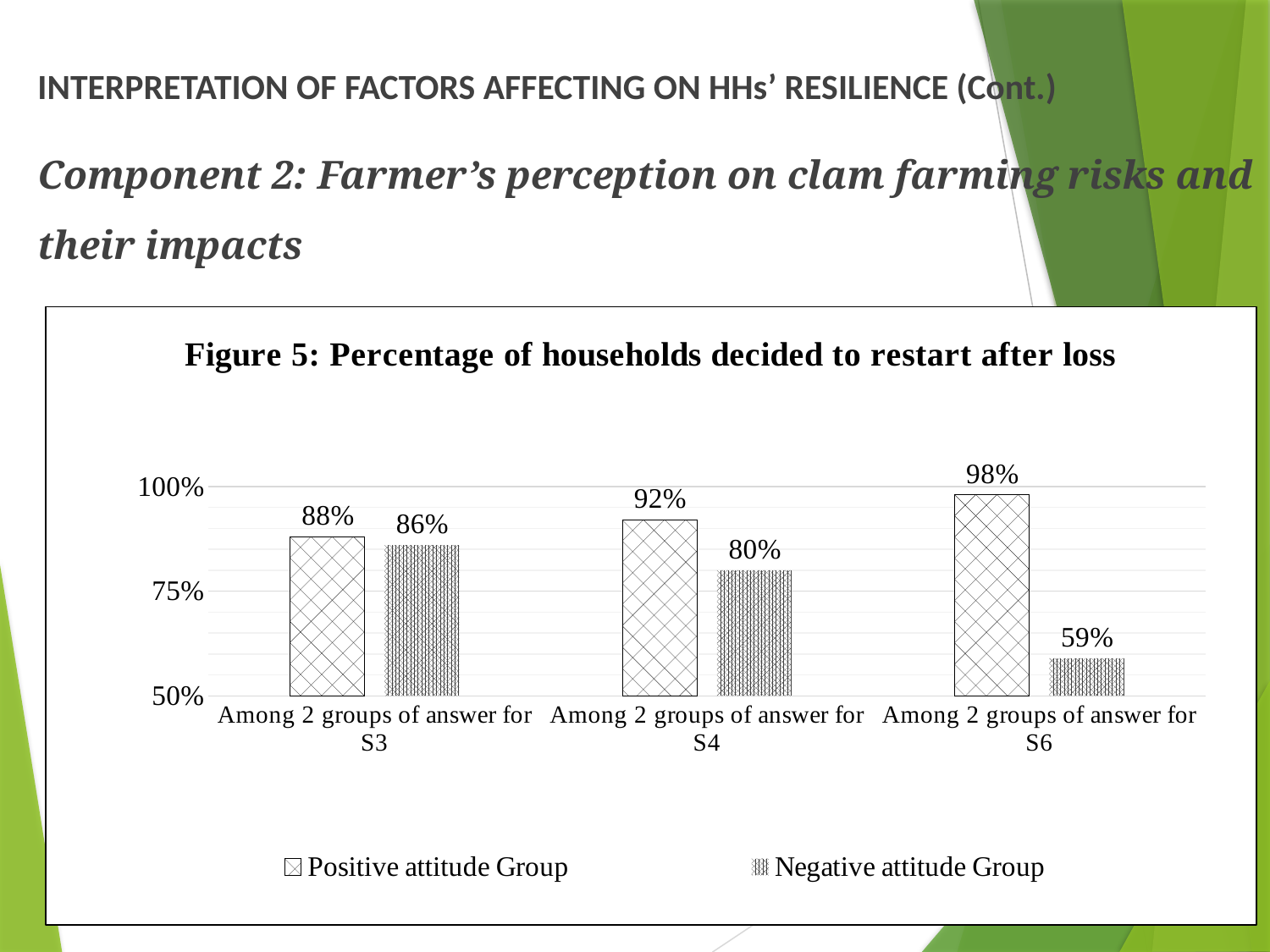
What is the difference between the Positive attitude Group and the Negative attitude Group for S4? 12% Which category has the highest value for the Positive attitude Group? Among 2 groups of answer for S6 Which is larger for S3: the Positive attitude Group or the Negative attitude Group? Positive attitude Group How many series does the legend list? 2 Which category has the lowest value for the Negative attitude Group? Among 2 groups of answer for S6 How many categories are shown on the x axis? 3 What is the value for the Negative attitude Group for S4? 80% What is the value for the Negative attitude Group for S6? 59% What is the title of the chart? Figure 5: Percentage of households decided to restart after loss What is the value for the Positive attitude Group for S3? 88% What kind of chart is shown? Bar chart What is the difference between the Positive attitude Group and the Negative attitude Group for S6? 39%